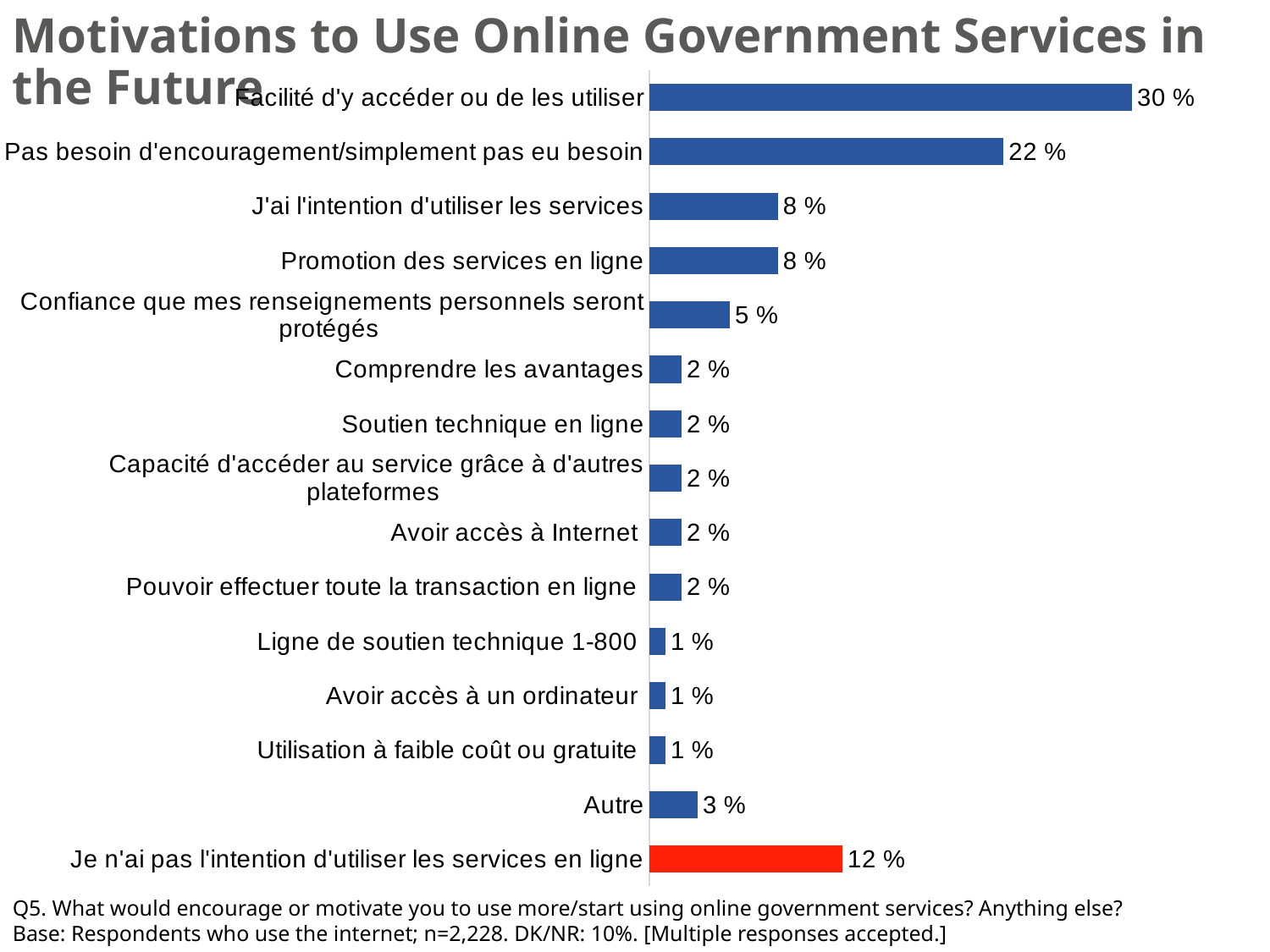
What kind of chart is shown on the slide? Bar chart Which category has the highest value? Facilité d'y accéder ou de les utiliser What is the value for "Confiance que mes renseignements personnels seront protégés"? 5 % Which is larger, "Pas besoin d'encouragement/simplement pas eu besoin" or "Je n'ai pas l'intention d'utiliser les services en ligne"? Pas besoin d'encouragement/simplement pas eu besoin What is the value for "Autre"? 3 % What is the difference between "Facilité d'y accéder ou de les utiliser" and "Pas besoin d'encouragement/simplement pas eu besoin"? 8 % What is the value for "Je n'ai pas l'intention d'utiliser les services en ligne"? 12 % Which is larger, "Autre" or "Avoir accès à Internet"? Autre What is the value for "Facilité d'y accéder ou de les utiliser"? 30 % How many categories are shown in the chart? 15 What is the difference between "Je n'ai pas l'intention d'utiliser les services en ligne" and "Promotion des services en ligne"? 4 % Which bar is coloured red rather than blue? Je n'ai pas l'intention d'utiliser les services en ligne